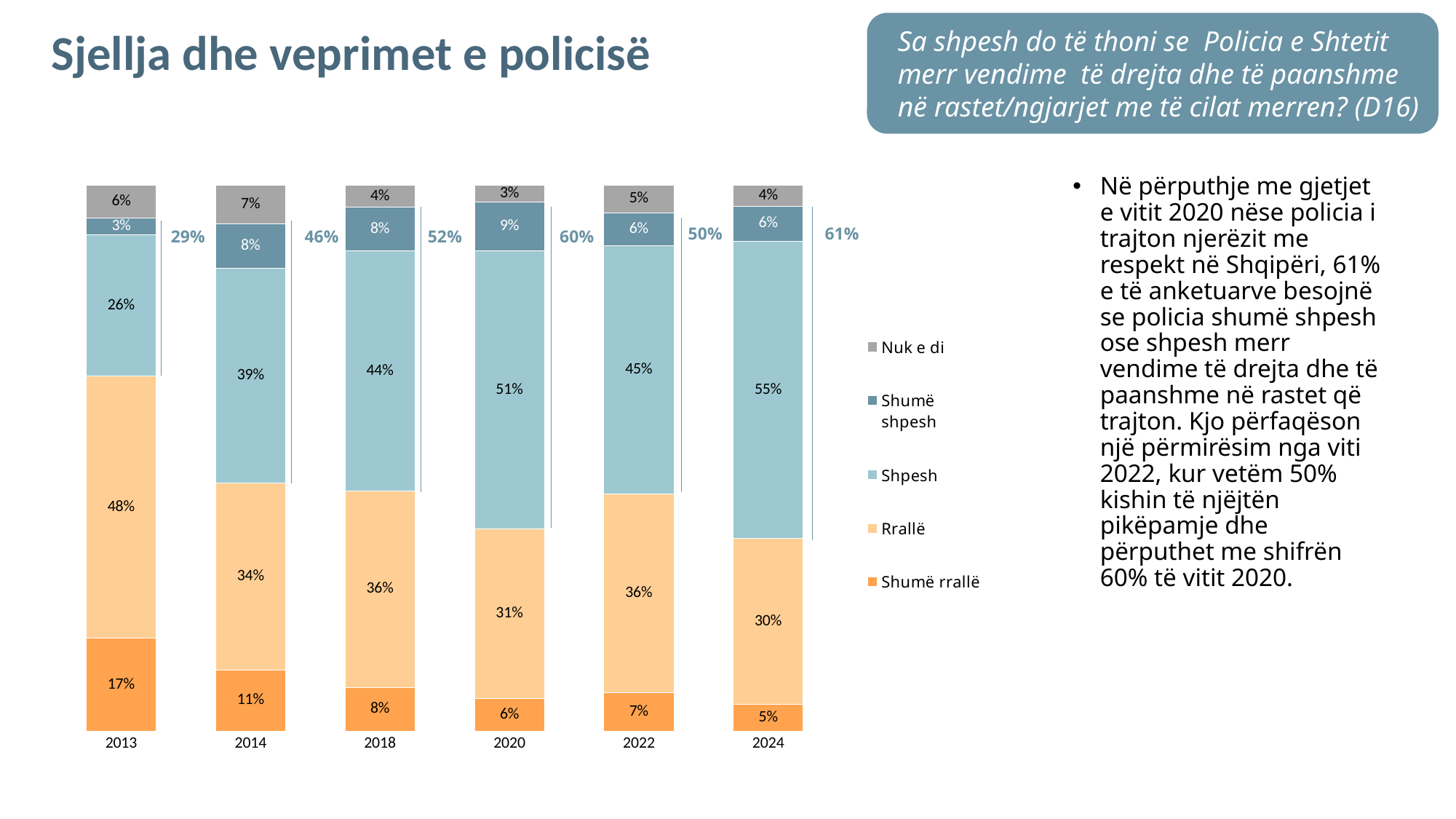
What is the difference between the "Rrallë" values for 2013 and 2024? 18% What is the value for "Rrallë" in 2020? 31% How many years are shown on the x axis? 6 What is the value for "Shumë rrallë" in 2013? 17% In which year is the "Shumë rrallë" value lowest? 2024 In which year is the "Shpesh" value highest? 2024 Which is larger: the "Shumë shpesh" value in 2020 or in 2022? 2020 What is the value for "Shumë shpesh" in 2018? 8% How many series does the legend list? 5 What is the combined value of "Shpesh" and "Shumë shpesh" for 2014, as labelled next to the bar? 46% What kind of chart is shown on the slide? Stacked bar chart What is the value for "Shpesh" in 2024? 55%